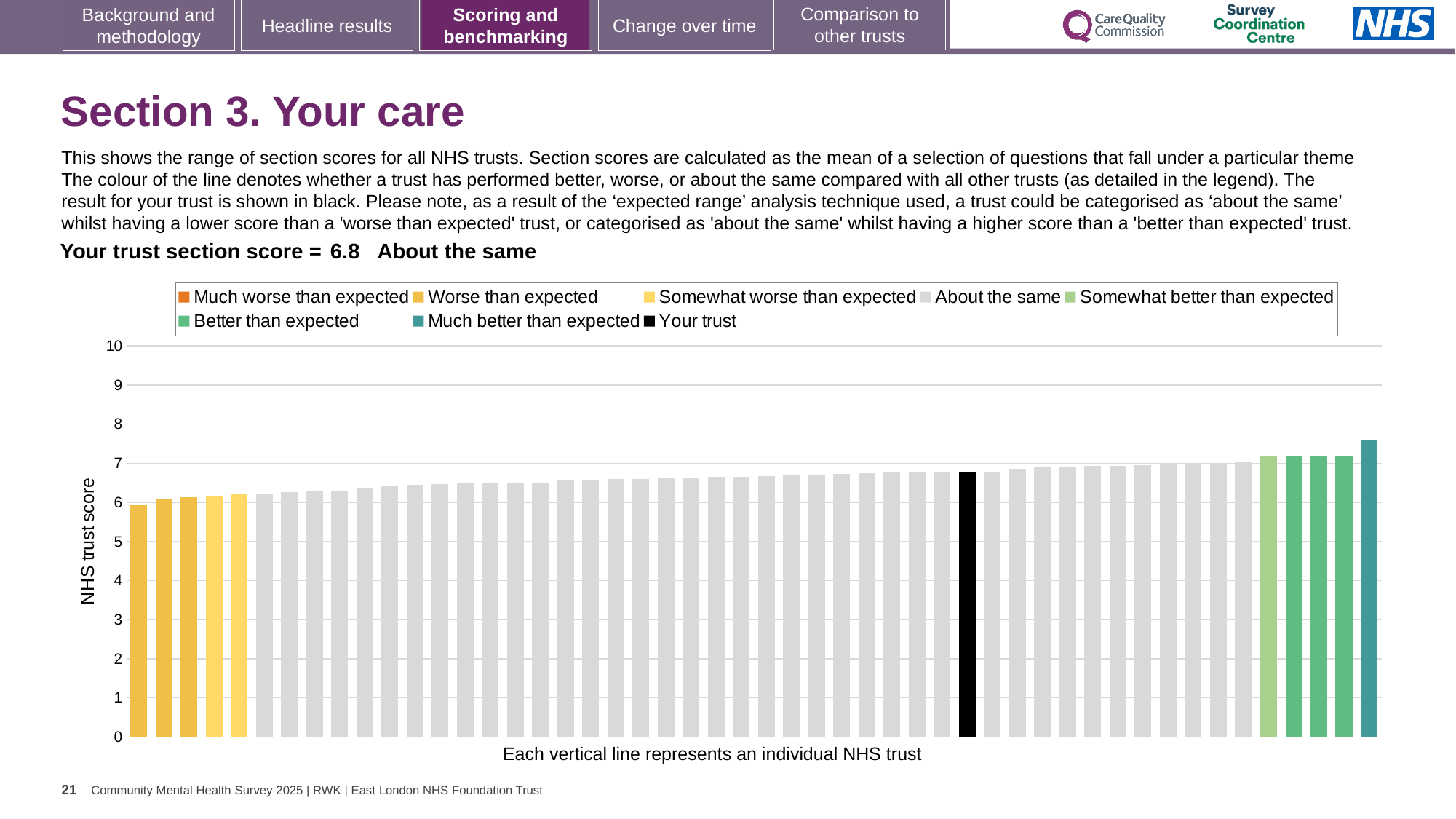
Which legend category does the tallest bar in the chart belong to? Much better than expected Which legend category does the shortest bar in the chart belong to? Worse than expected How many entries does the chart legend list? 8 What is the title of the vertical axis of the chart? NHS trust score Is the value of the leftmost bar in the chart greater or less than 7? less What kind of chart is shown on the slide? bar chart What is the section score for your trust shown on the slide? 6.8 Is the black 'Your trust' bar taller or shorter than the teal bar at the far right? shorter Is the value of the black 'Your trust' bar greater or less than 5? greater Do the bar values rise or fall from left to right along the x axis? rise Is the value of the tallest bar in the chart greater or less than 7? greater Which category is your trust's section score placed in, according to the text above the chart? About the same